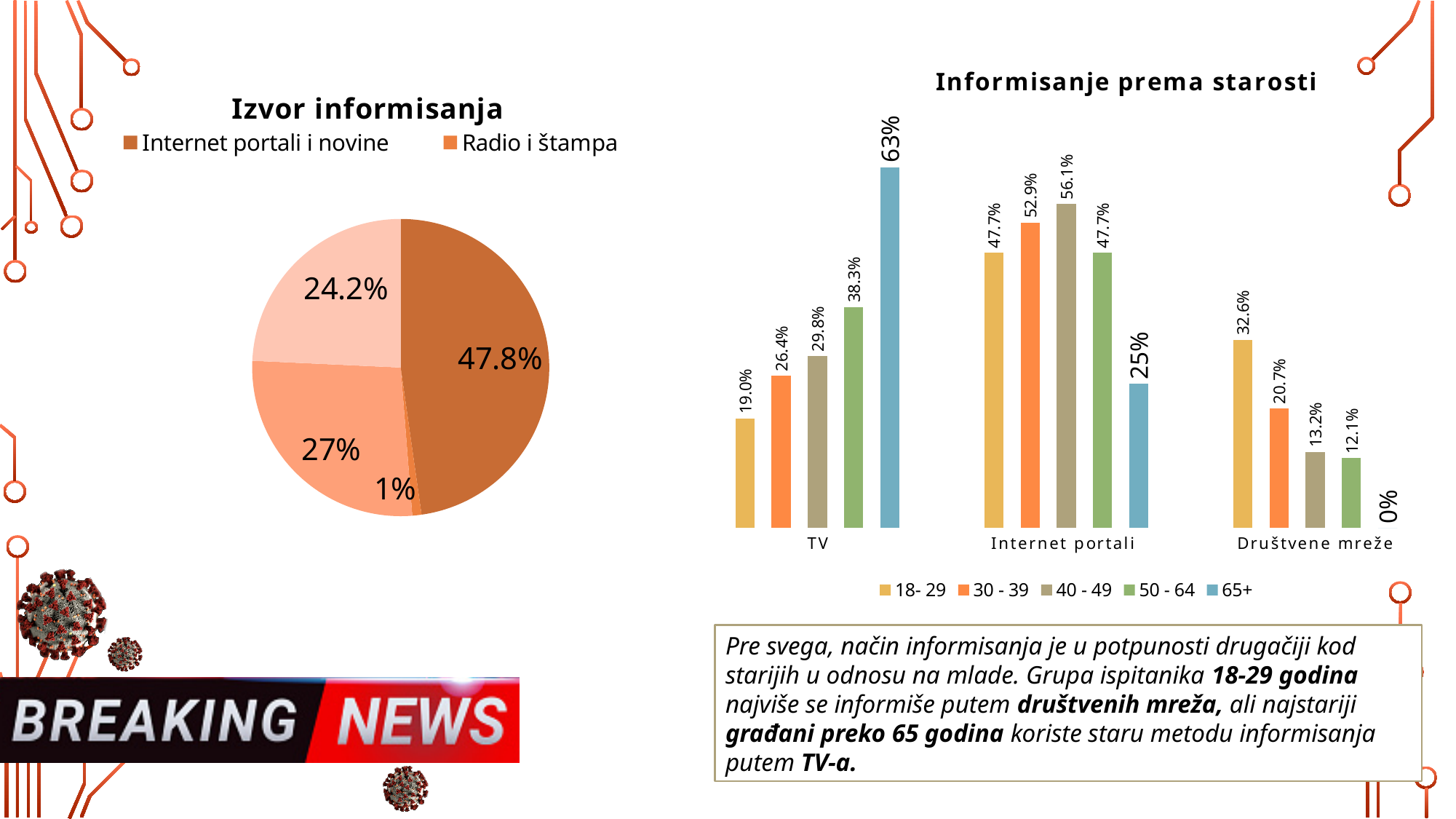
In the 'Informisanje prema starosti' chart, which age group has the highest value for TV? 65+ How many age-group series does the legend of the 'Informisanje prema starosti' chart list? 5 In the 'Izvor informisanja' pie chart, what is the share of the largest slice? 47.8% In the 'Informisanje prema starosti' chart, what is the value for the 18- 29 group for Društvene mreže? 32.6% What kind of chart is 'Izvor informisanja'? Pie chart What kind of chart is 'Informisanje prema starosti'? Bar chart How many categories are shown on the x axis of the 'Informisanje prema starosti' chart? 3 In the 'Informisanje prema starosti' chart, which is larger for Internet portali: the 30 - 39 value or the 50 - 64 value? 30 - 39 In the 'Informisanje prema starosti' chart, which age group has the lowest value for Društvene mreže? 65+ In the 'Informisanje prema starosti' chart, what is the difference between the 65+ value for TV and the 65+ value for Internet portali? 38 percentage points In the 'Informisanje prema starosti' chart, what is the value for the 40 - 49 group for Internet portali? 56.1% In the 'Informisanje prema starosti' chart, what is the value for the 65+ group for TV? 63%